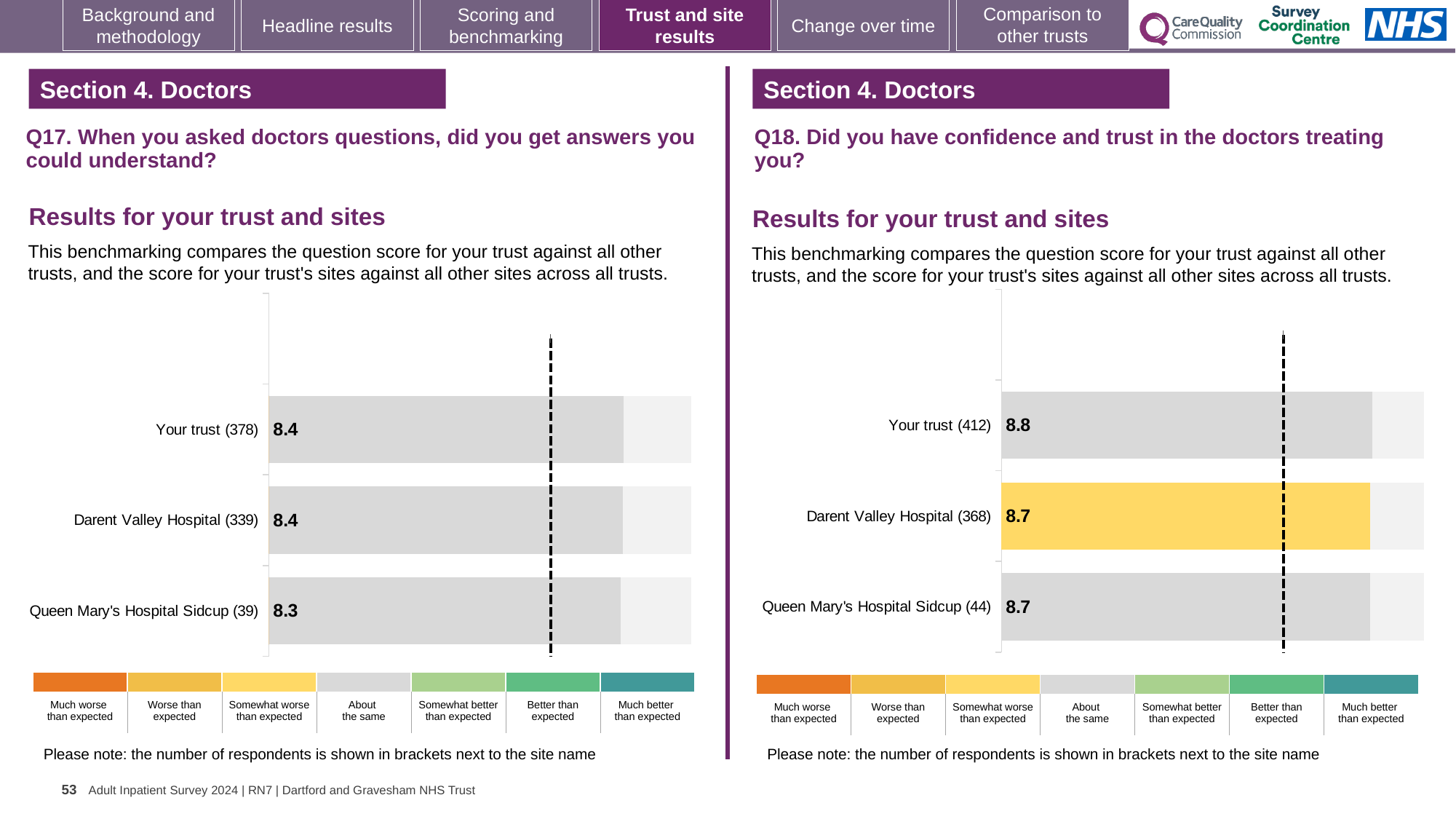
What type of chart is used on the Q17 chart? Bar chart Which is larger: the Your trust score on the Q17 chart or the Your trust score on the Q18 chart? Q18 chart On the Q18 chart, what is the score for Darent Valley Hospital (368)? 8.7 On the Q18 chart, which site or trust has the highest score? Your trust (412) On the Q17 chart, which site or trust has the lowest score? Queen Mary's Hospital Sidcup (39) On the Q18 chart, what is the difference between the score for Your trust (412) and the score for Queen Mary's Hospital Sidcup (44)? 0.1 On the Q17 chart, what is the difference between the score for Darent Valley Hospital (339) and the score for Queen Mary's Hospital Sidcup (39)? 0.1 On the Q18 chart, what is the score for Your trust (412)? 8.8 On the Q17 chart, what is the score for Queen Mary's Hospital Sidcup (39)? 8.3 On the Q17 chart, what is the score for Your trust (378)? 8.4 On the Q18 chart, which benchmark category does the colour of the Darent Valley Hospital (368) bar indicate? Somewhat worse than expected How many bars are plotted on the Q18 chart? 3